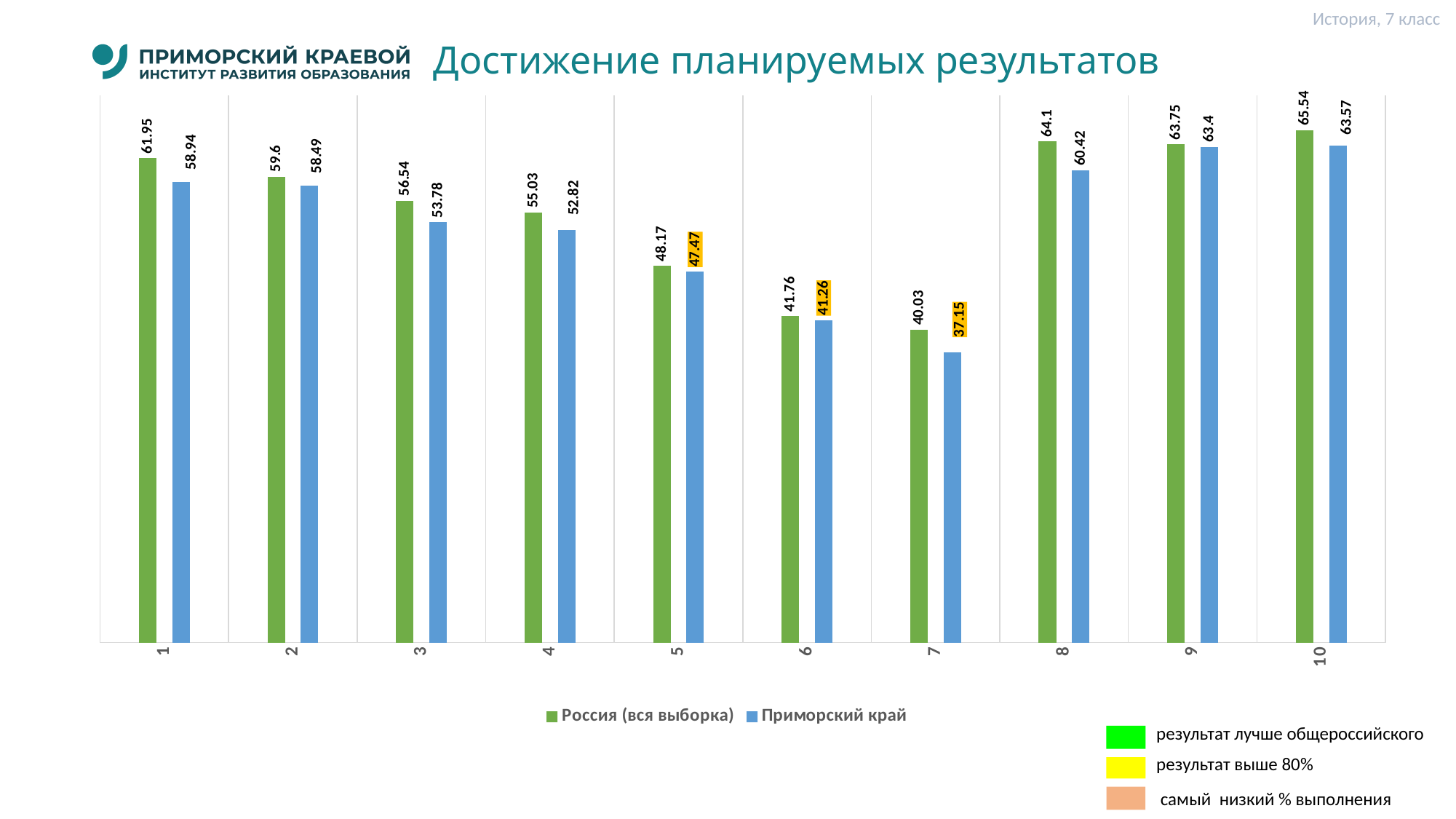
What is the value for Приморский край at category 10? 63.57 At category 8, which series has the larger value: Россия (вся выборка) or Приморский край? Россия (вся выборка) Which category has the highest value for Россия (вся выборка)? 10 From category 1 to category 7, do the values for Россия (вся выборка) rise or fall? fall What kind of chart is shown on the slide? bar chart What is the value for Приморский край at category 7? 37.15 How many series does the legend list? 2 Which category has the lowest value for Приморский край? 7 How many categories are shown on the x axis? 10 What is the value for Россия (вся выборка) at category 1? 61.95 What is the difference between Россия (вся выборка) and Приморский край at category 1? 3.01 What is the difference between Россия (вся выборка) and Приморский край at category 7? 2.88